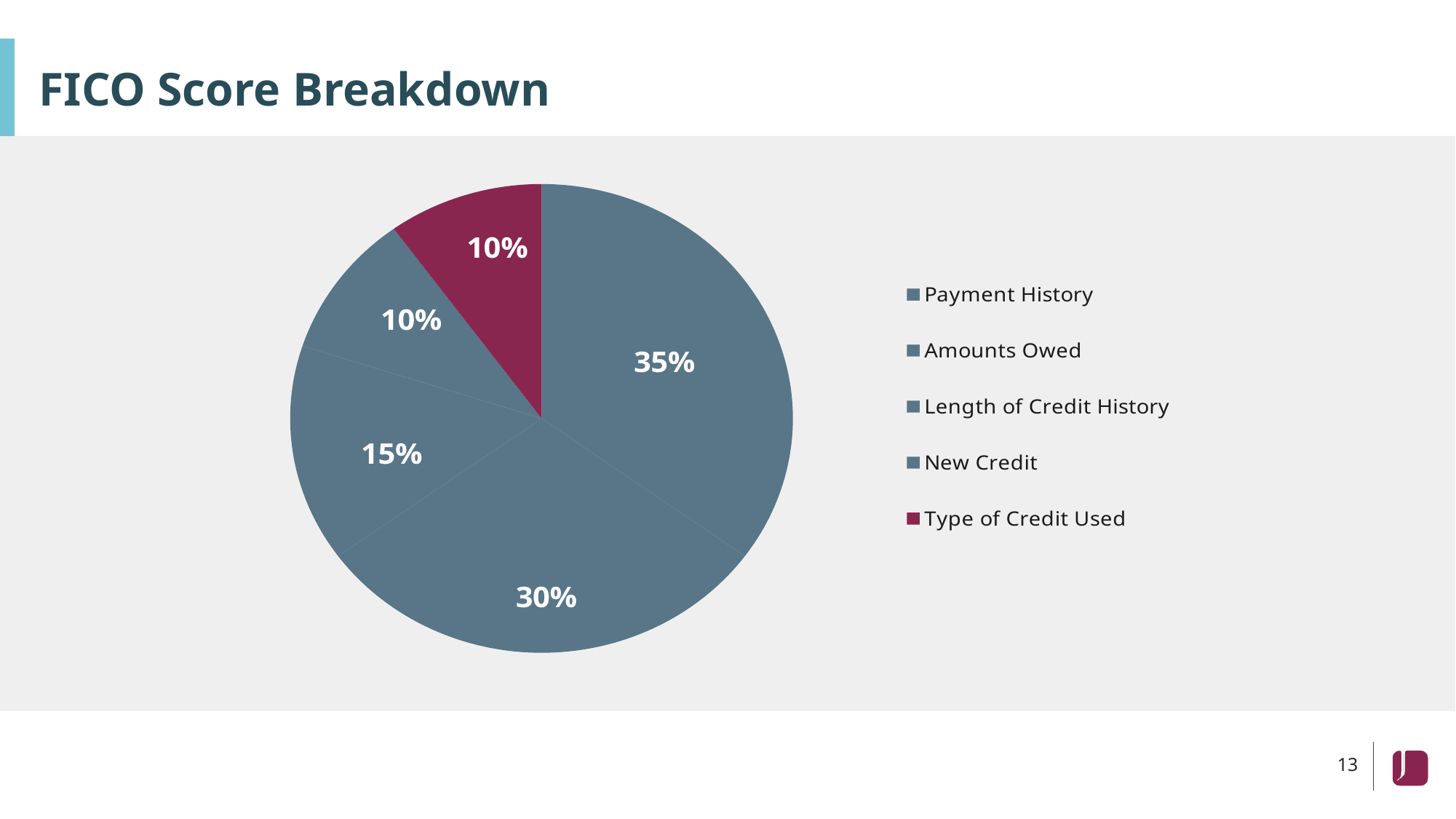
Which legend entry is shown in maroon rather than slate blue? Type of Credit Used How many entries does the legend list? 5 What share of the pie does Amounts Owed represent? 30% How many slices does the pie chart have? 5 What is the difference between the largest slice (35%) and the 30% slice? 5% What is the smallest share shown in the pie chart? 10% What is the title of the slide containing the pie chart? FICO Score Breakdown Which is larger, the 15% slice or the 30% slice? the 30% slice What kind of chart is shown on the slide? pie chart What is the largest share shown in the pie chart? 35% What share of the pie does Payment History represent? 35% What share of the pie does the maroon slice (Type of Credit Used) represent? 10%